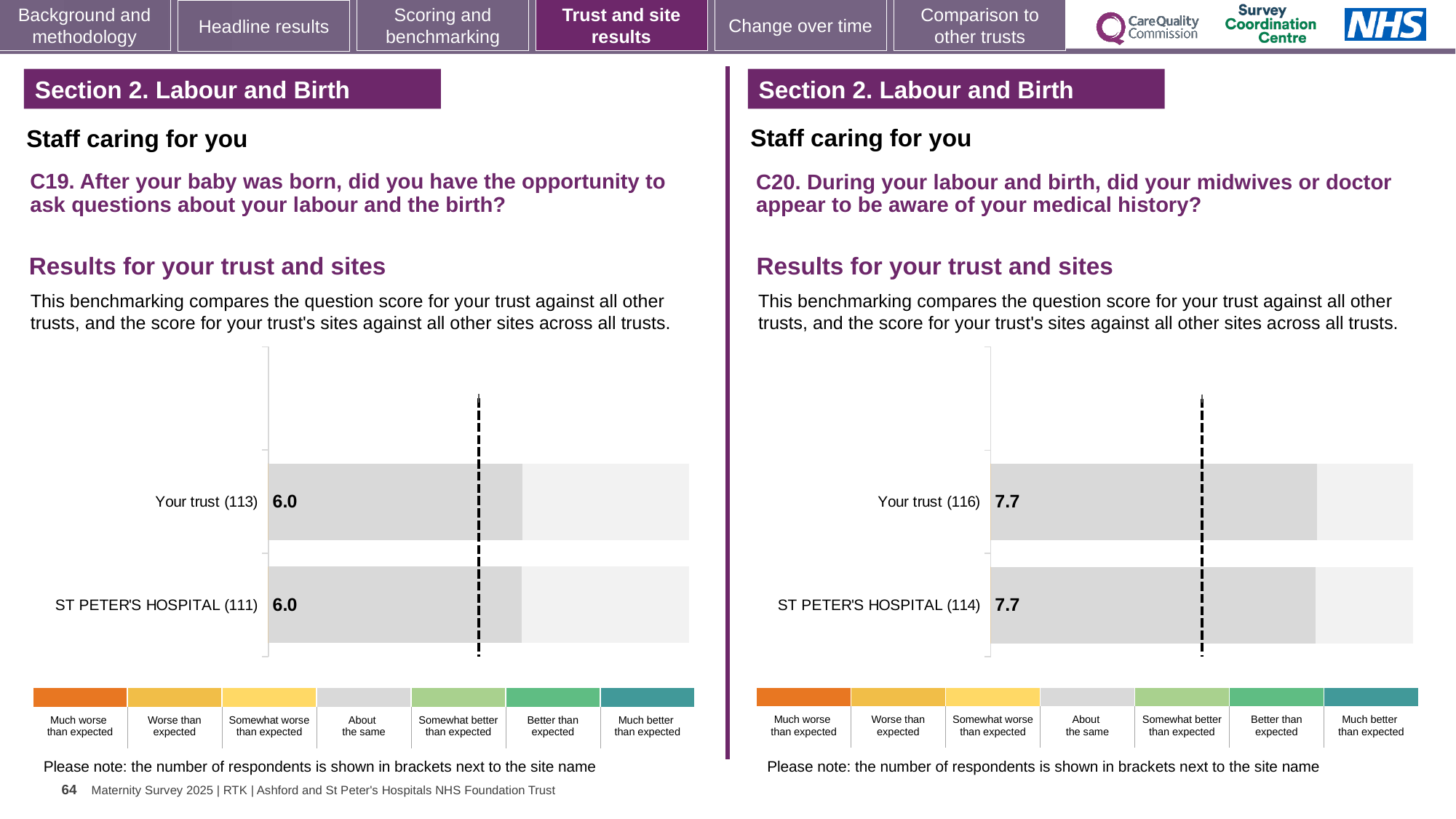
In the C20 chart on the right, what is the score for Your trust? 7.7 How many categories does the colour key below each chart list, from 'Much worse than expected' to 'Much better than expected'? 7 Which is larger: the Your trust score in the C19 chart on the left or the Your trust score in the C20 chart on the right? C20 chart (7.7) How many bars are plotted in the C20 chart on the right? 2 In the C19 chart on the left, what is the score for Your trust? 6.0 What is the difference between the Your trust score in the C20 chart on the right and the Your trust score in the C19 chart on the left? 1.7 In the C20 chart on the right, what is the score for ST PETER'S HOSPITAL? 7.7 How many bars are plotted in the C19 chart on the left? 2 What kind of chart is used in the C19 chart on the left? Bar chart In the C20 chart on the right, how many respondents are shown in brackets for ST PETER'S HOSPITAL? 114 In the C19 chart on the left, what is the score for ST PETER'S HOSPITAL? 6.0 In the C19 chart on the left, how many respondents are shown in brackets for Your trust? 113